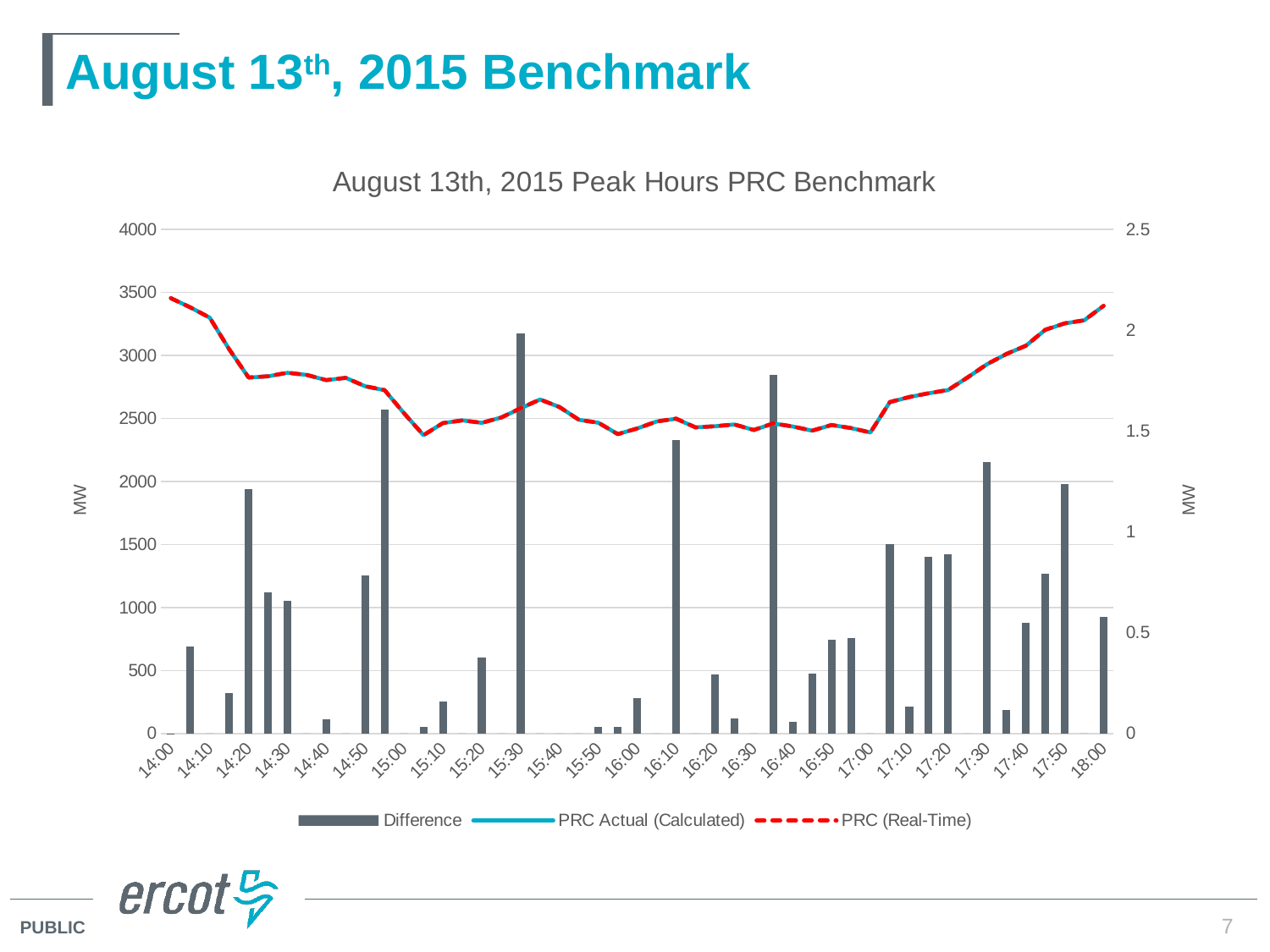
At which time is the Difference bar highest? 15:30 Is the PRC (Real-Time) value at 14:00 greater or less than 2 on the right axis? greater Which series is drawn as bars in the chart? Difference Which has the larger Difference value, 14:20 or 14:30? 14:20 Does the PRC (Real-Time) line rise or fall between 17:00 and 18:00? rise Is the Difference value at 14:40 greater or less than 500? less What is the title of the chart? August 13th, 2015 Peak Hours PRC Benchmark What kind of chart is shown on the slide? A combination bar and line chart How many series does the legend list? 3